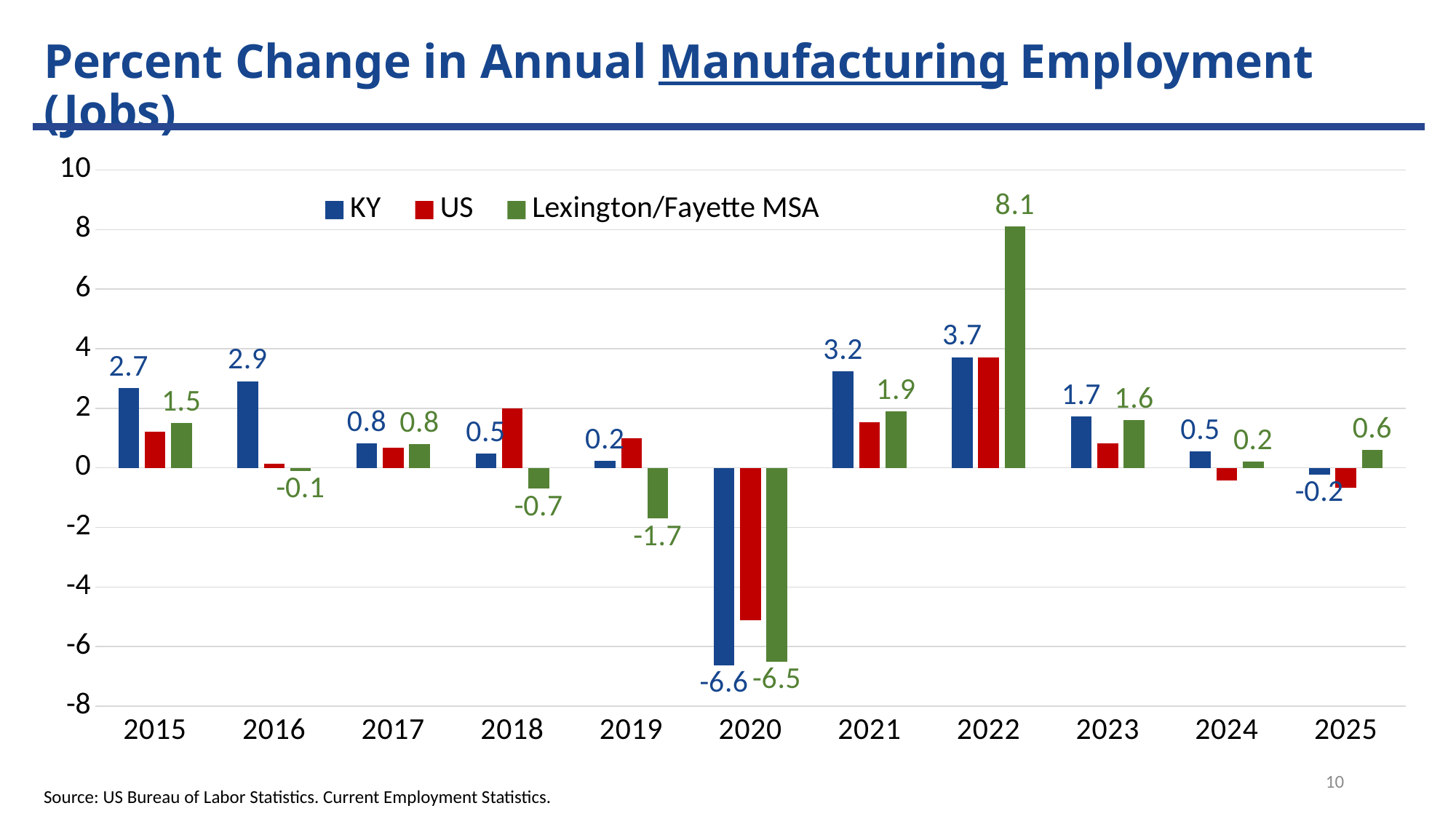
Which is larger in 2015, the KY value or the Lexington/Fayette MSA value? KY What is the value for Lexington/Fayette MSA in 2019? -1.7 In which year is the KY value lowest? 2020 What is the value for KY in 2016? 2.9 What is the difference between the Lexington/Fayette MSA values in 2022 and 2021? 6.2 How many series does the legend list? 3 What kind of chart is shown on the slide? bar chart In which year is the Lexington/Fayette MSA value highest? 2022 How many years are shown on the x axis? 11 What is the value for KY in 2020? -6.6 What is the value for Lexington/Fayette MSA in 2022? 8.1 Is the US value for 2020 greater or less than -4? less